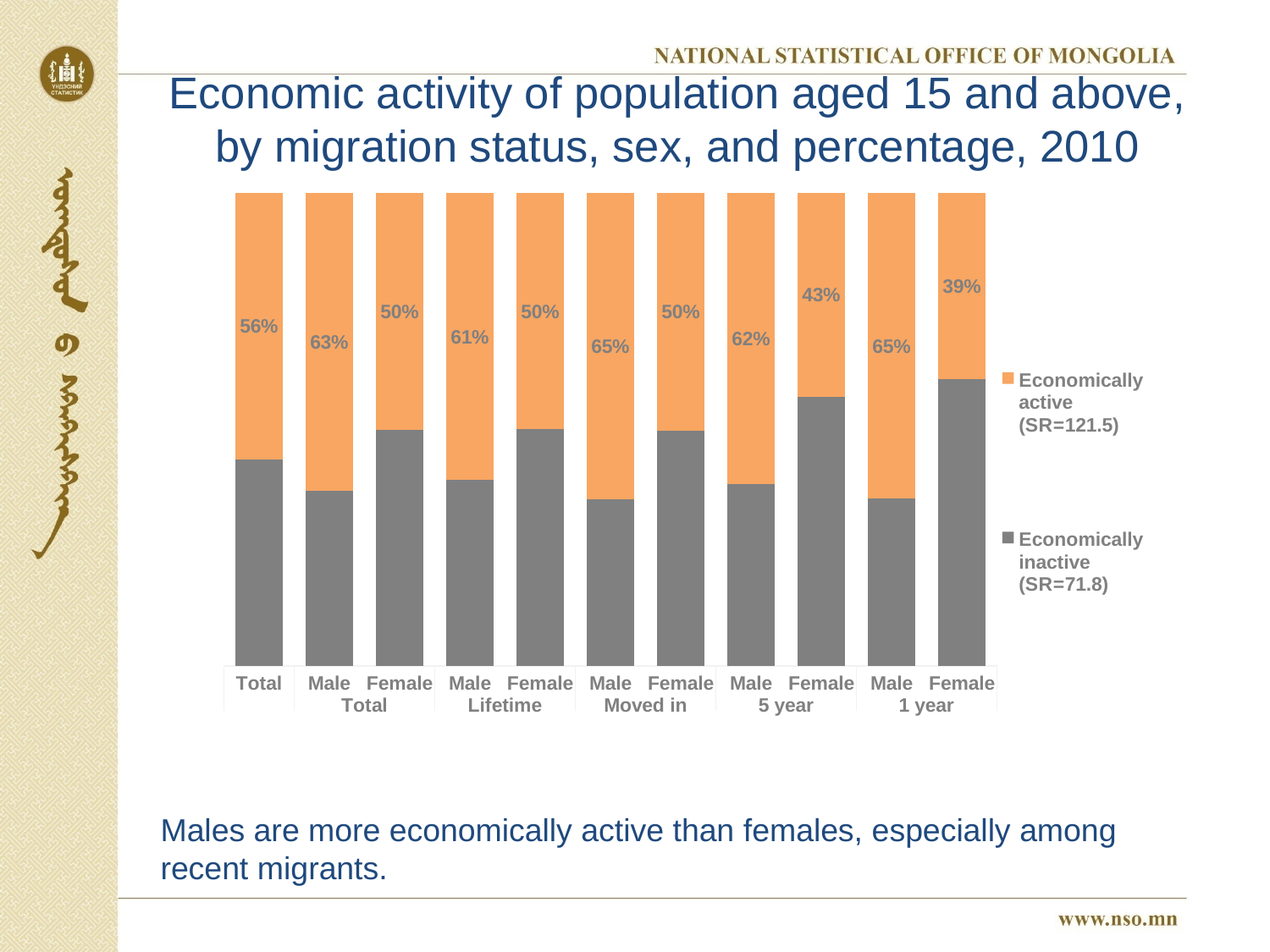
What is the economically active percentage for Male Moved in? 65% Which colour represents the Economically inactive series? Grey How many series does the legend list? 2 What kind of chart is shown on the slide? Stacked bar chart What is the difference in economically active percentage between Male Total and Female Total? 13 percentage points What is the difference in economically active percentage between Male 1 year and Female 1 year? 26 percentage points What is the economically active percentage for the Total category? 56% Which category has the lowest economically active percentage? Female 1 year What is the economically active percentage for Female 5 year migrants? 43% How many bars are shown in the chart? 11 What is the economically active percentage for Female 1 year migrants? 39% Which has a higher economically active percentage, Male 5 year or Female 5 year? Male 5 year